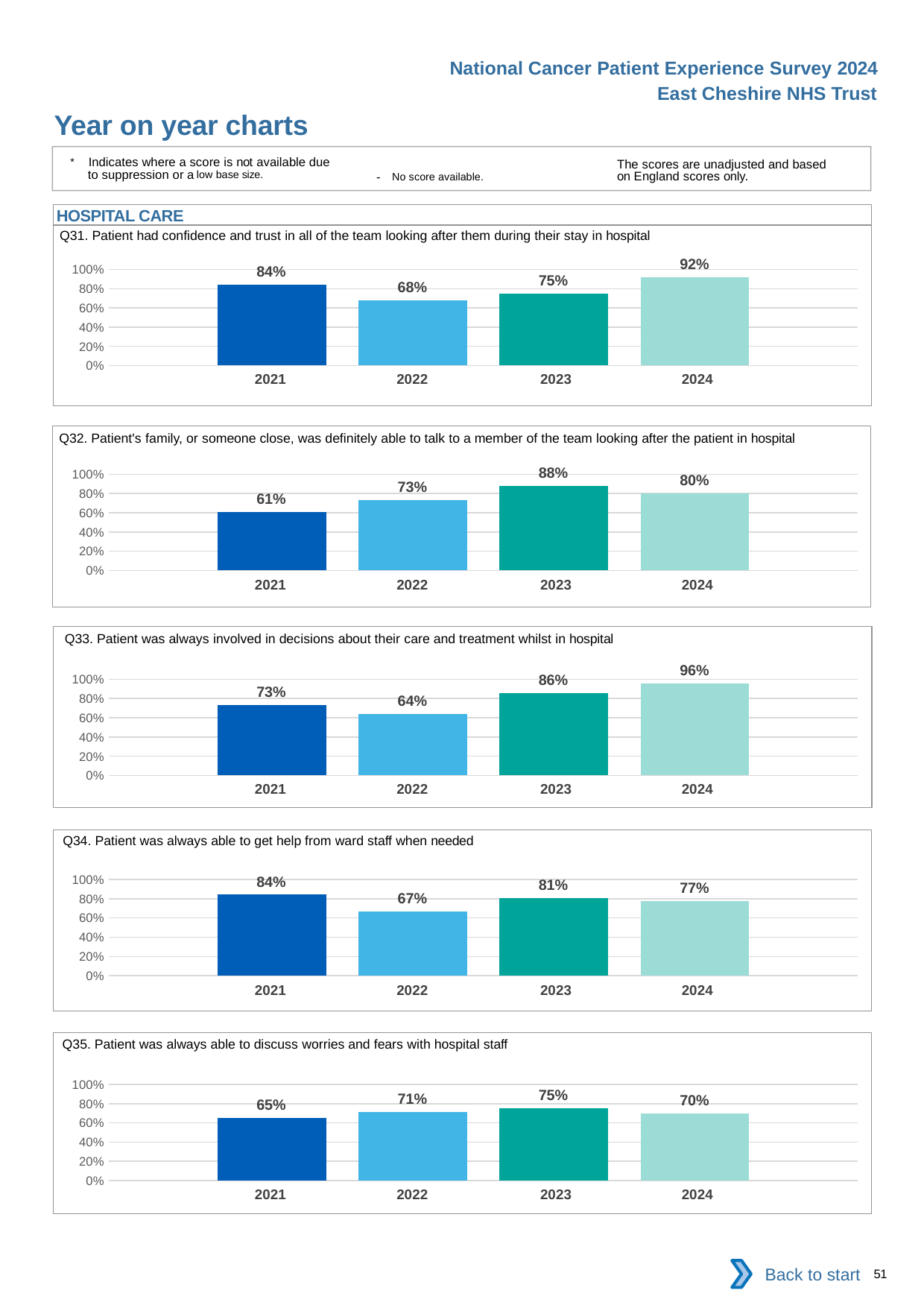
In the Q33 chart, do the values rise or fall from 2022 to 2024? Rise In the Q31 chart, what is the difference between the 2024 and 2022 values? 24% In the Q35 chart, what is the value for 2022? 71% How many bars are plotted in the Q33 chart? 4 In the Q32 chart, what is the value for 2021? 61% In the Q34 chart, what is the difference between the 2021 and 2022 values? 17% In the Q31 chart, what is the value for 2024? 92% In the Q32 chart, which year has the highest value? 2023 What kind of chart is the Q34 chart? Bar chart In the Q33 chart, which year has the lowest value? 2022 In the Q35 chart, which is larger, the value for 2023 or the value for 2024? 2023 How many charts are shown on the slide? 5